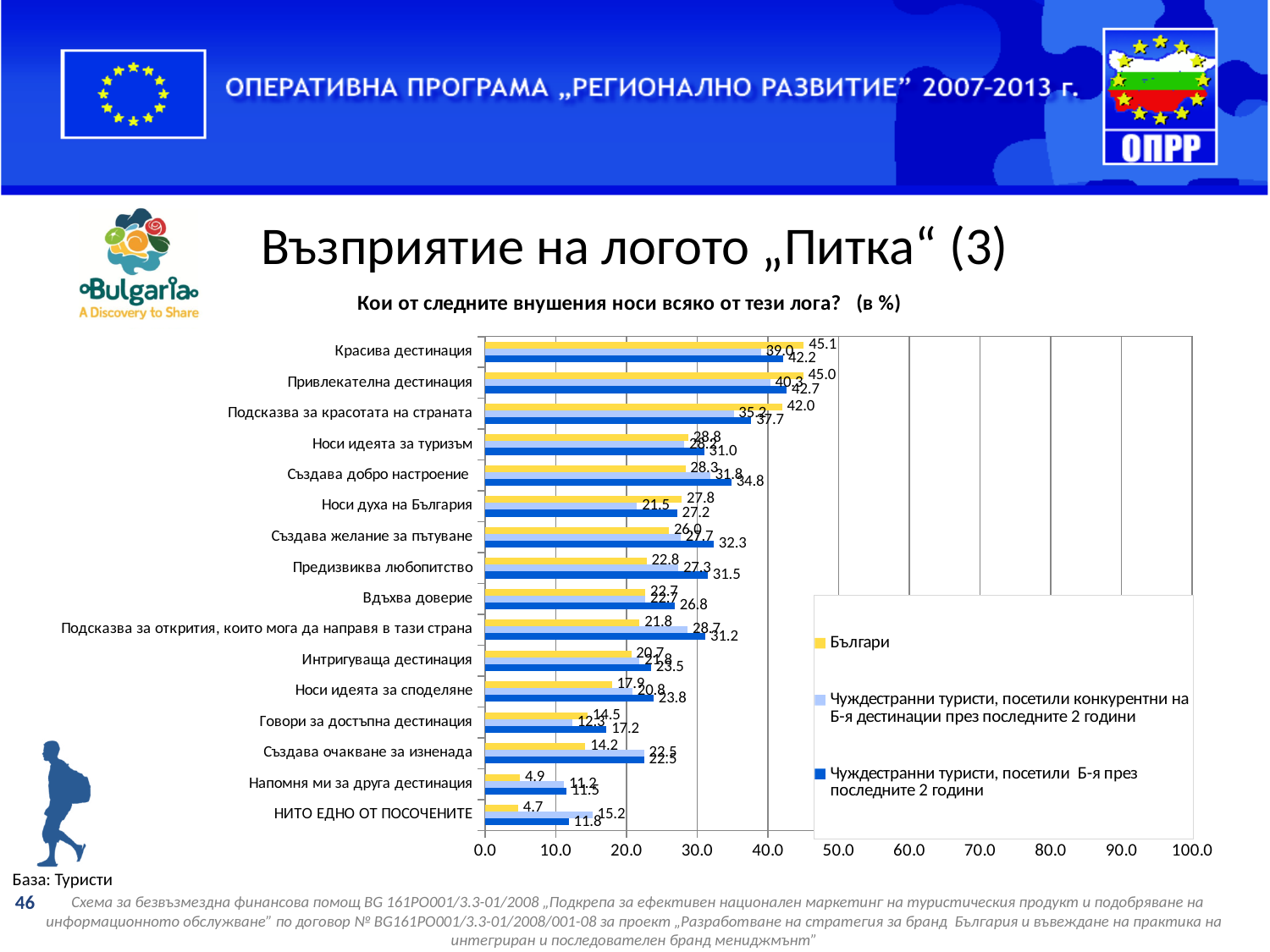
How many series does the legend list? 3 What is the value for Българи for "Красива дестинация"? 45.1 What is the value for Българи for "НИТО ЕДНО ОТ ПОСОЧЕНИТЕ"? 4.7 Which category has the lowest value for Българи? НИТО ЕДНО ОТ ПОСОЧЕНИТЕ Which category has the highest value for Българи? Красива дестинация What type of chart is shown on the slide? bar chart What is the value for "Чуждестранни туристи, посетили Б-я през последните 2 години" for "Създава добро настроение"? 34.8 What is the difference between the Българи value and the "Чуждестранни туристи, посетили Б-я през последните 2 години" value for "Подсказва за красотата на страната"? 4.3 How many categories (statements) are plotted on the chart? 16 Is the value for Българи for "Привлекателна дестинация" greater or less than 40.0? greater For "Напомня ми за друга дестинация", which is larger: the value for Българи or the value for "Чуждестранни туристи, посетили Б-я през последните 2 години"? Чуждестранни туристи, посетили Б-я през последните 2 години What is the title of the chart? Кои от следните внушения носи всяко от тези лога? (в %)